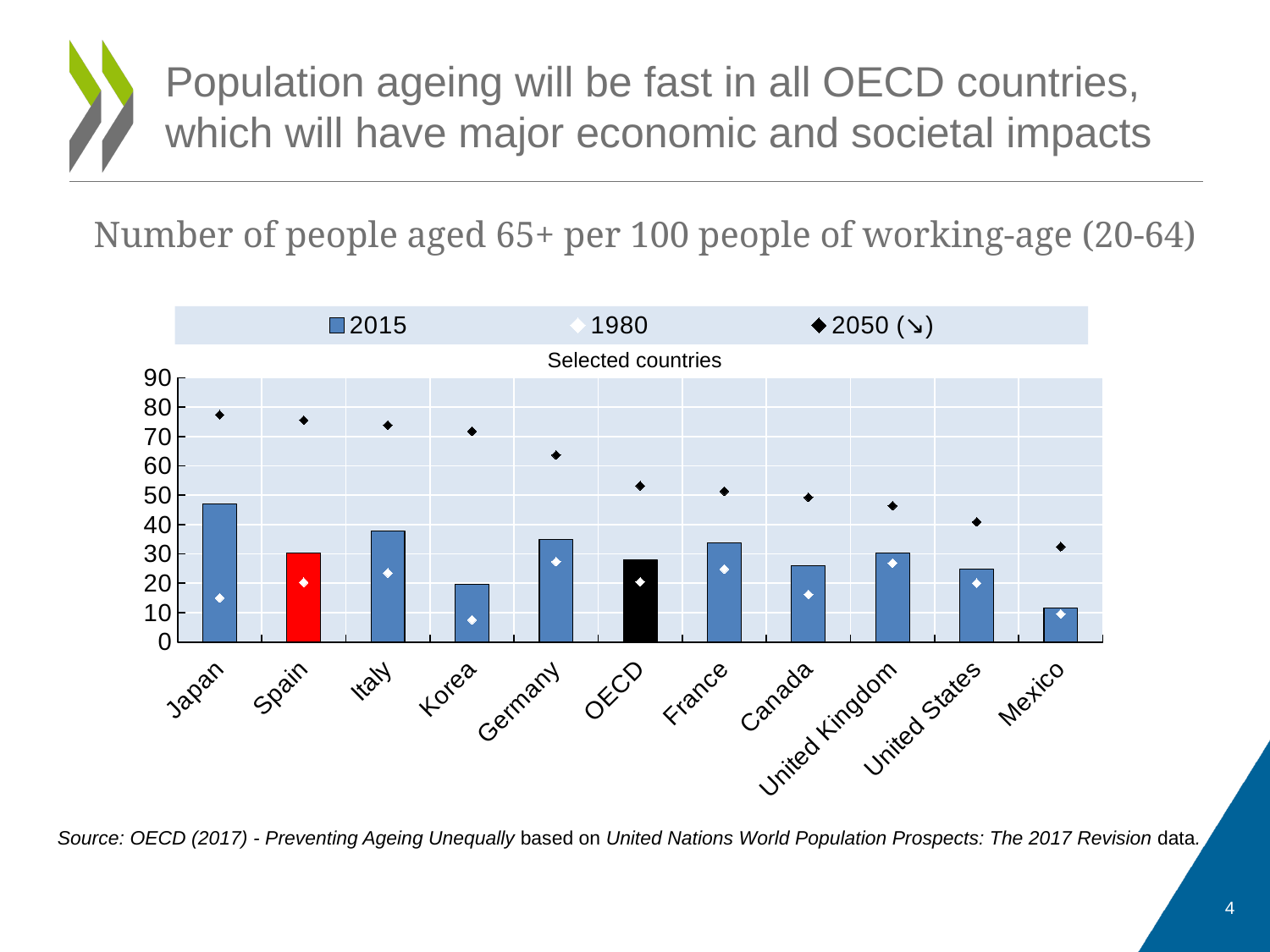
Which country has the lowest 2050 value? Mexico Do the 2050 values rise or fall moving from Japan on the left to Mexico on the right? fall Is the 2015 value for Japan greater or less than 40? greater How many countries or groups are shown along the x axis? 11 Which country's 2015 bar is coloured red? Spain Which country has the highest 2015 value? Japan Is the 2015 value for Korea greater or less than 30? less How many series does the legend list? 3 Which country has the lowest 2015 value? Mexico Is the 2050 value for Germany greater or less than 60? greater Which is larger, the 2050 value for Korea or the 2050 value for Germany? Korea What kind of chart is shown on the slide? bar chart